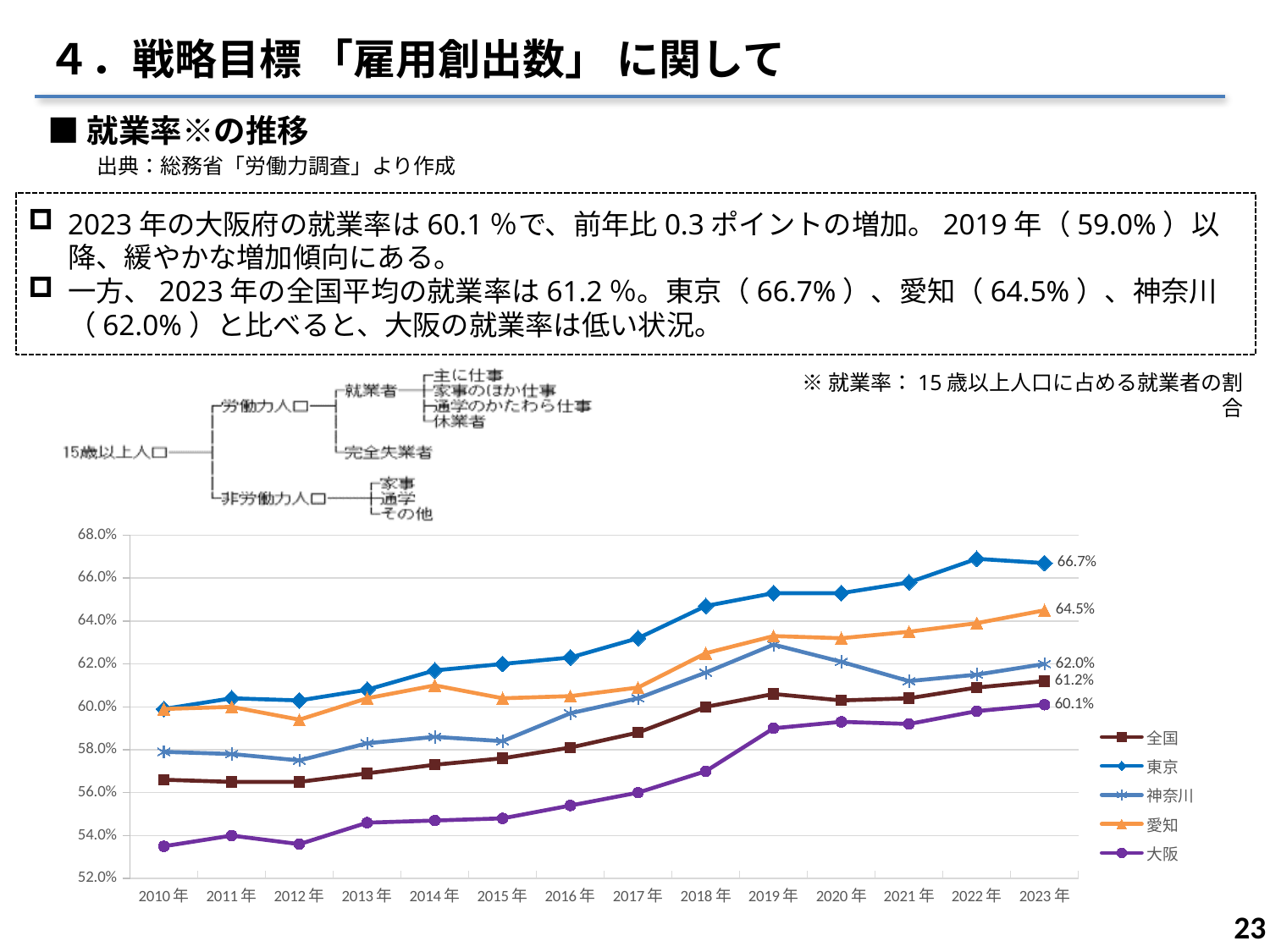
What is the value for 東京 in 2023年? 66.7% In 2023年, which is larger, 愛知 or 神奈川? 愛知 How many years are plotted along the x axis? 14 What kind of chart is shown on the slide? line chart What is the difference between 東京 and 大阪 in 2023年? 6.6 points What is the value for 大阪 in 2023年? 60.1% Which series has the highest value in 2023年? 東京 Does the 大阪 line generally rise or fall from 2010年 to 2023年? rise Is the value for 大阪 in 2010年 greater or less than 54.0%? less Which series has the lowest value in 2023年? 大阪 How many series does the legend list? 5 What is the value for 愛知 in 2023年? 64.5%